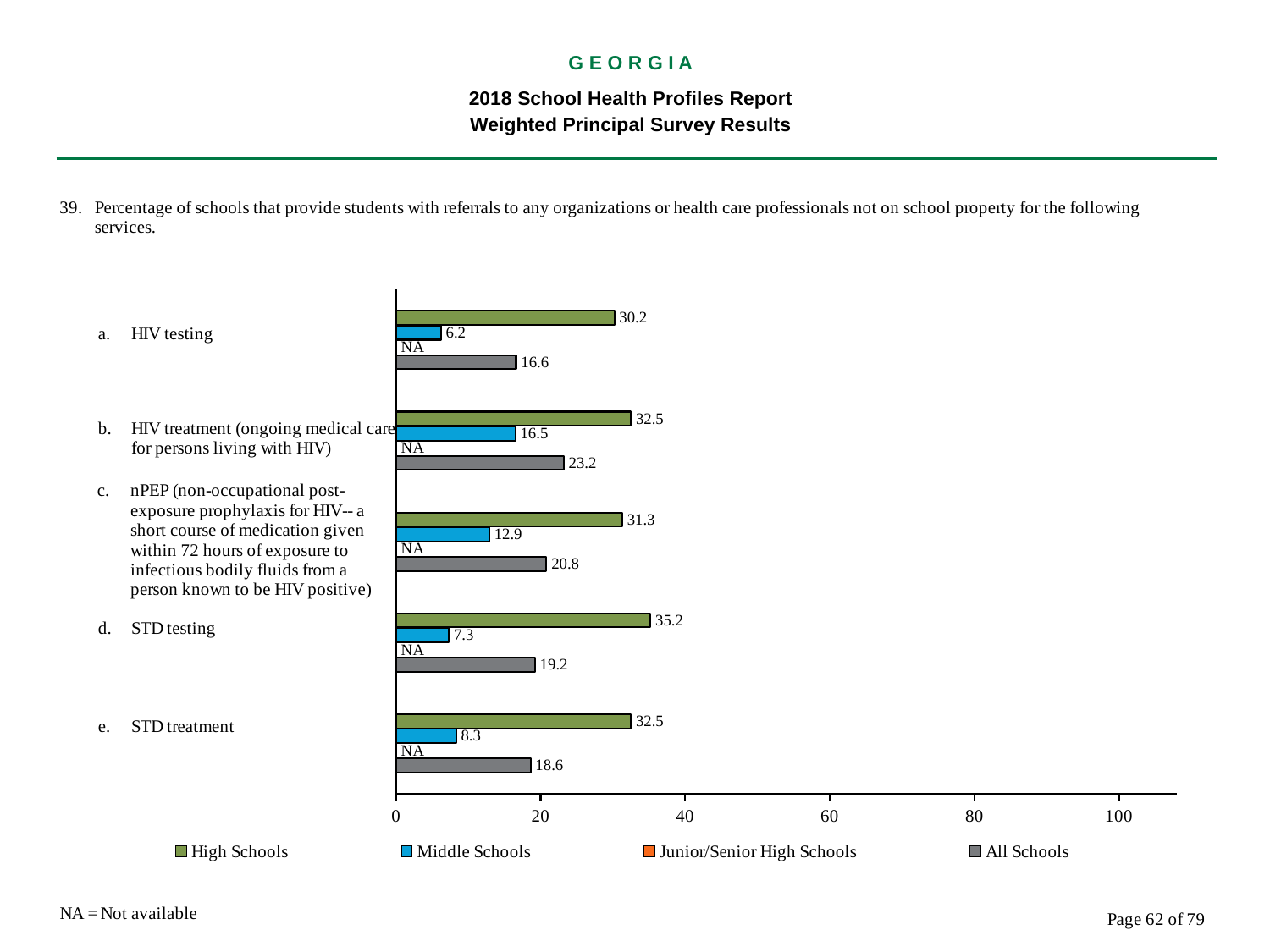
What kind of chart is shown on the slide? Bar chart What is the All Schools value for nPEP? 20.8 What is the High Schools value for STD testing? 35.2 Which service has the highest High Schools value? STD testing What is the Middle Schools value for HIV treatment (ongoing medical care for persons living with HIV)? 16.5 How many services (categories) are shown in the chart? 5 Which service has the highest All Schools value? HIV treatment (ongoing medical care for persons living with HIV) How many series does the legend list? 4 Which service has the lowest Middle Schools value? HIV testing What is the difference between the High Schools and Middle Schools values for STD testing? 27.9 Is the High Schools value for HIV testing greater or less than 20? greater Which is larger for STD treatment: the All Schools value or the Middle Schools value? All Schools